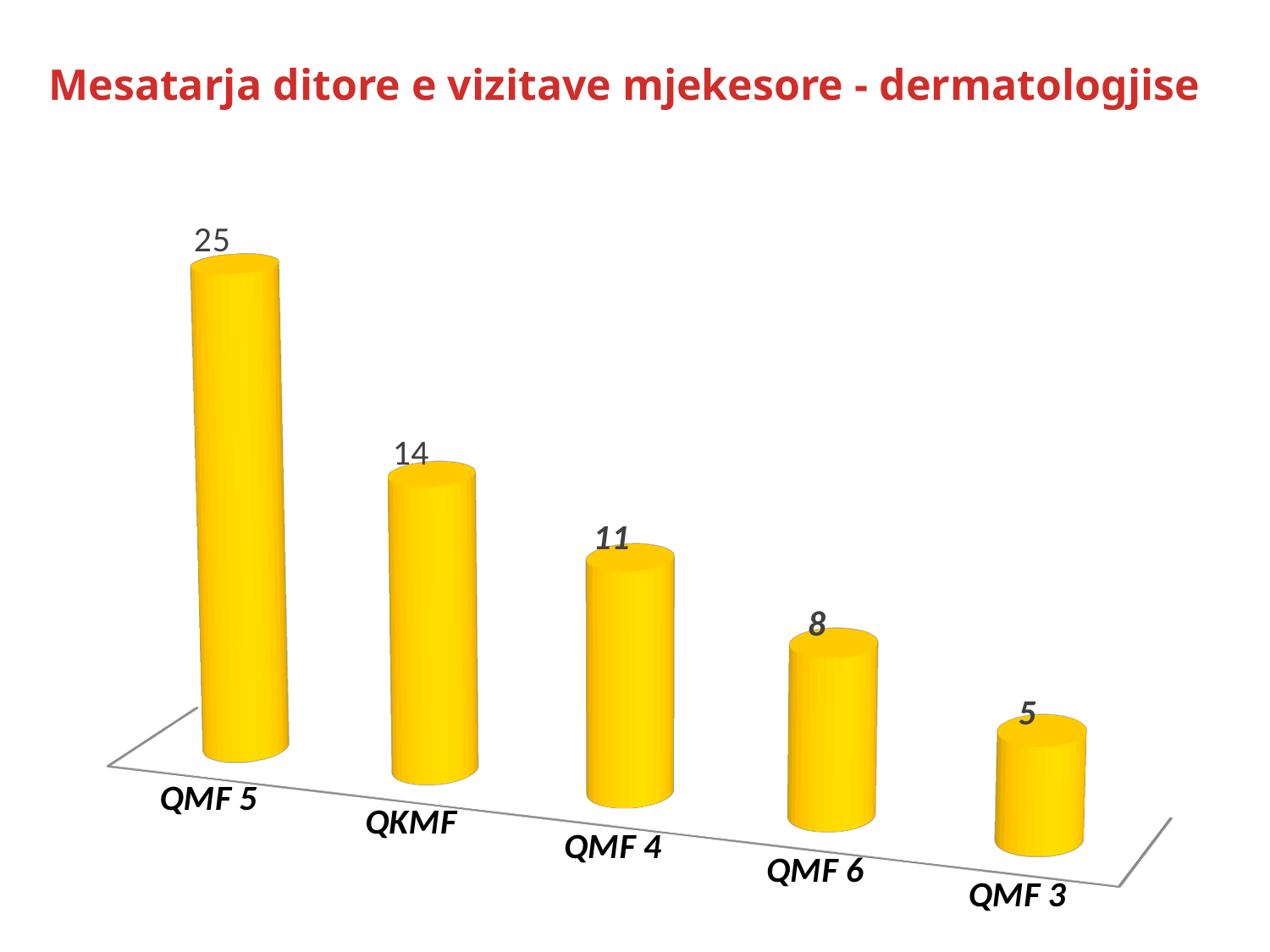
What kind of chart is shown on the slide? Bar chart What is the title of the chart? Mesatarja ditore e vizitave mjekesore - dermatologjise What is the value for QMF 4? 11 Which is larger, the value for QMF 4 or the value for QMF 6? QMF 4 What is the value for QMF 6? 8 Which category has the lowest value? QMF 3 How many categories are shown in the chart? 5 What is the value for QKMF? 14 What is the difference between the values for QMF 5 and QKMF? 11 Which category has the highest value? QMF 5 What is the value for QMF 5? 25 What is the value for QMF 3? 5